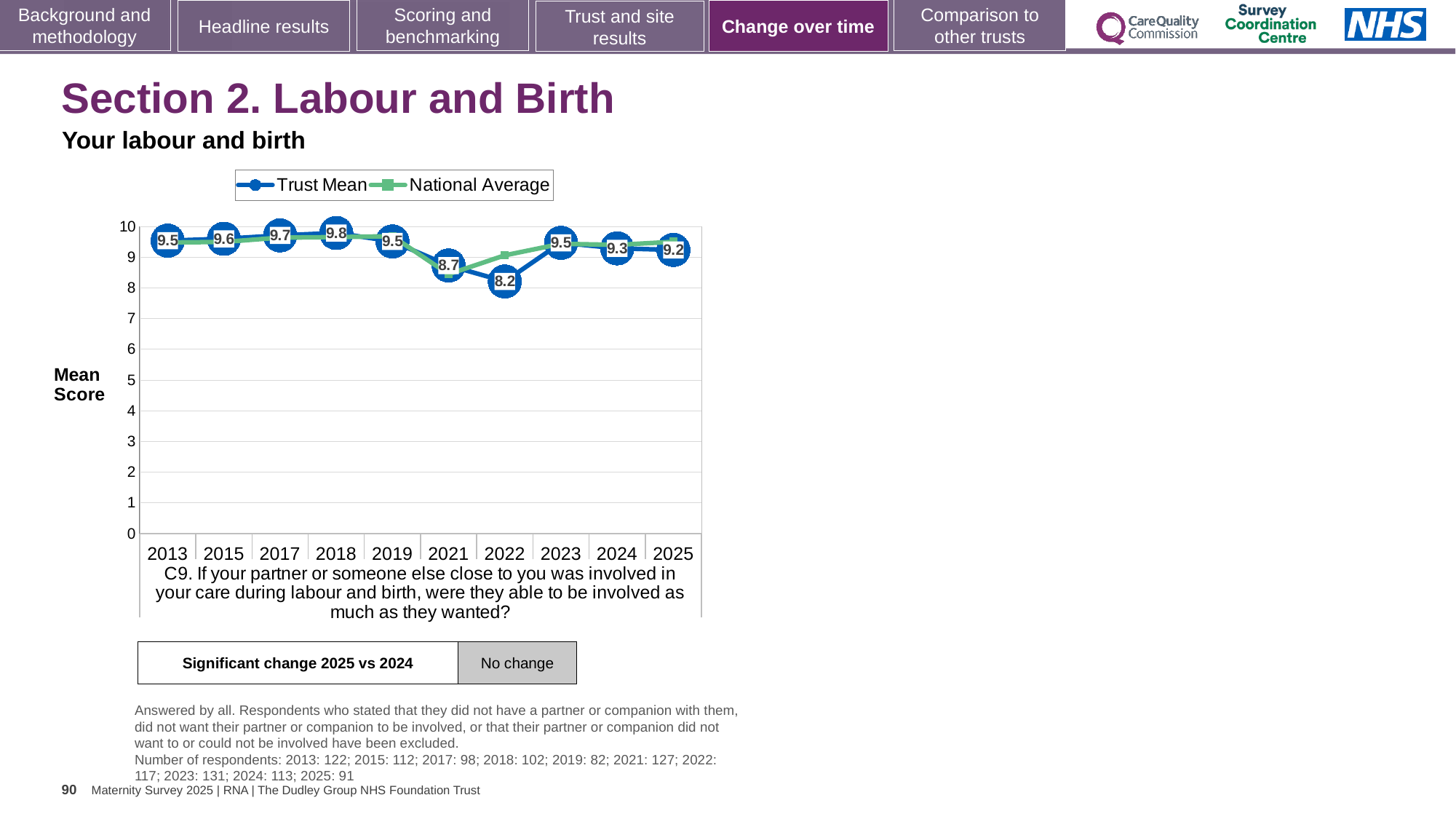
Which is larger, the Trust Mean in 2021 or in 2023? 2023 Does the Trust Mean rise or fall from 2023 to 2025? fall What is the difference between the Trust Mean in 2018 and in 2022? 1.6 How many series does the legend list? 2 What is the Trust Mean for 2022? 8.2 In which year is the Trust Mean highest? 2018 What kind of chart is shown? line chart What is the Trust Mean for 2018? 9.8 What is the Trust Mean for 2025? 9.2 In which year is the Trust Mean lowest? 2022 How many years are shown on the x axis? 10